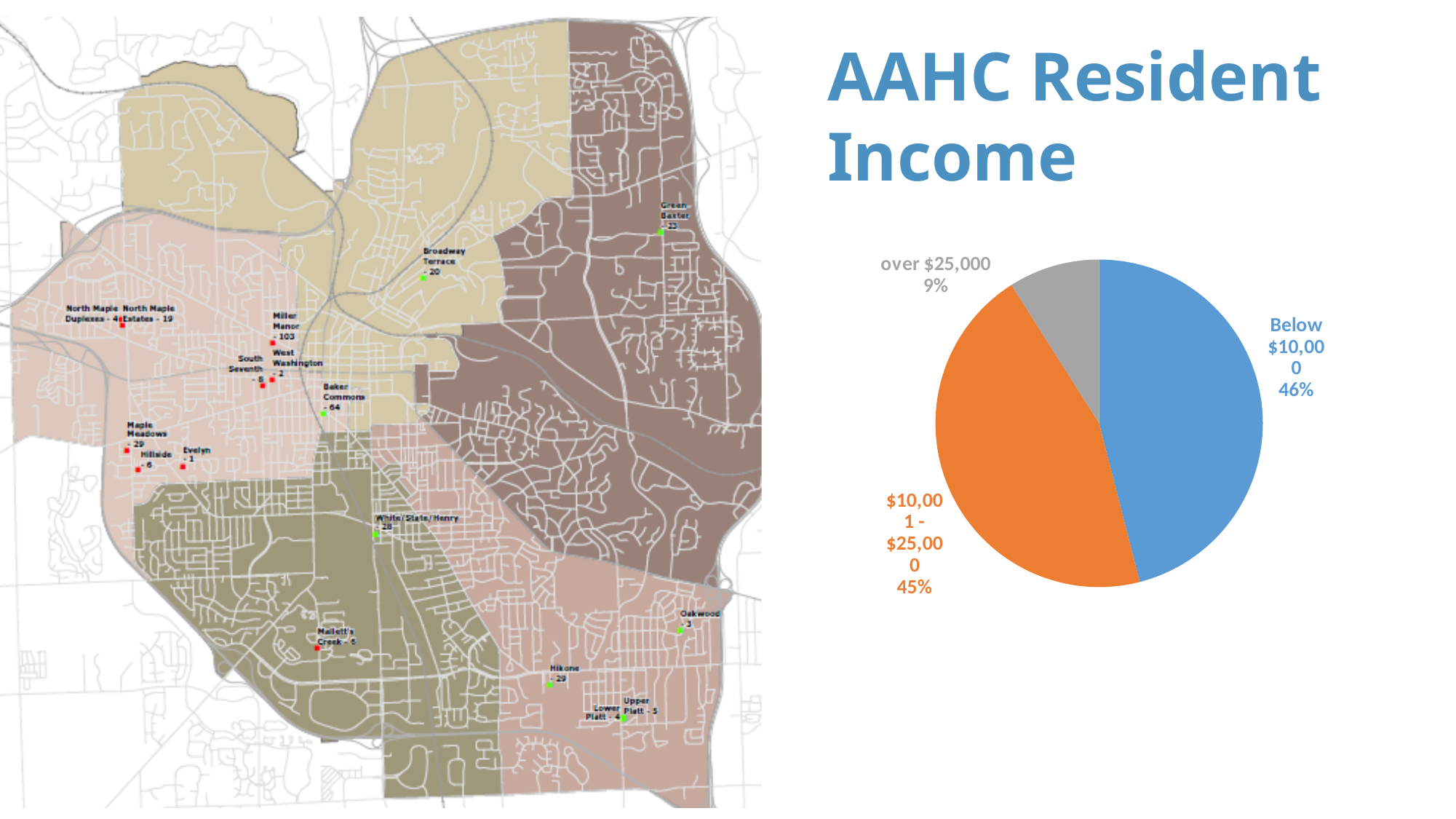
What is the title of the slide containing the pie chart? AAHC Resident Income Which income category has the smallest share in the pie chart? over $25,000 What is the difference in percentage points between the Below $10,000 slice and the $10,001 - $25,000 slice? 1 Which income category has the largest share in the pie chart? Below $10,000 What share of AAHC residents have income of $10,001 - $25,000? 45% What share of AAHC residents have income below $10,000? 46% What share of AAHC residents have income over $25,000? 9% What is the difference in percentage points between the Below $10,000 slice and the over $25,000 slice? 37 What colour is the slice for income over $25,000? grey How many slices does the pie chart have? 3 Which is larger: the share for $10,001 - $25,000 or the share for over $25,000? $10,001 - $25,000 What kind of chart is shown on the slide? pie chart